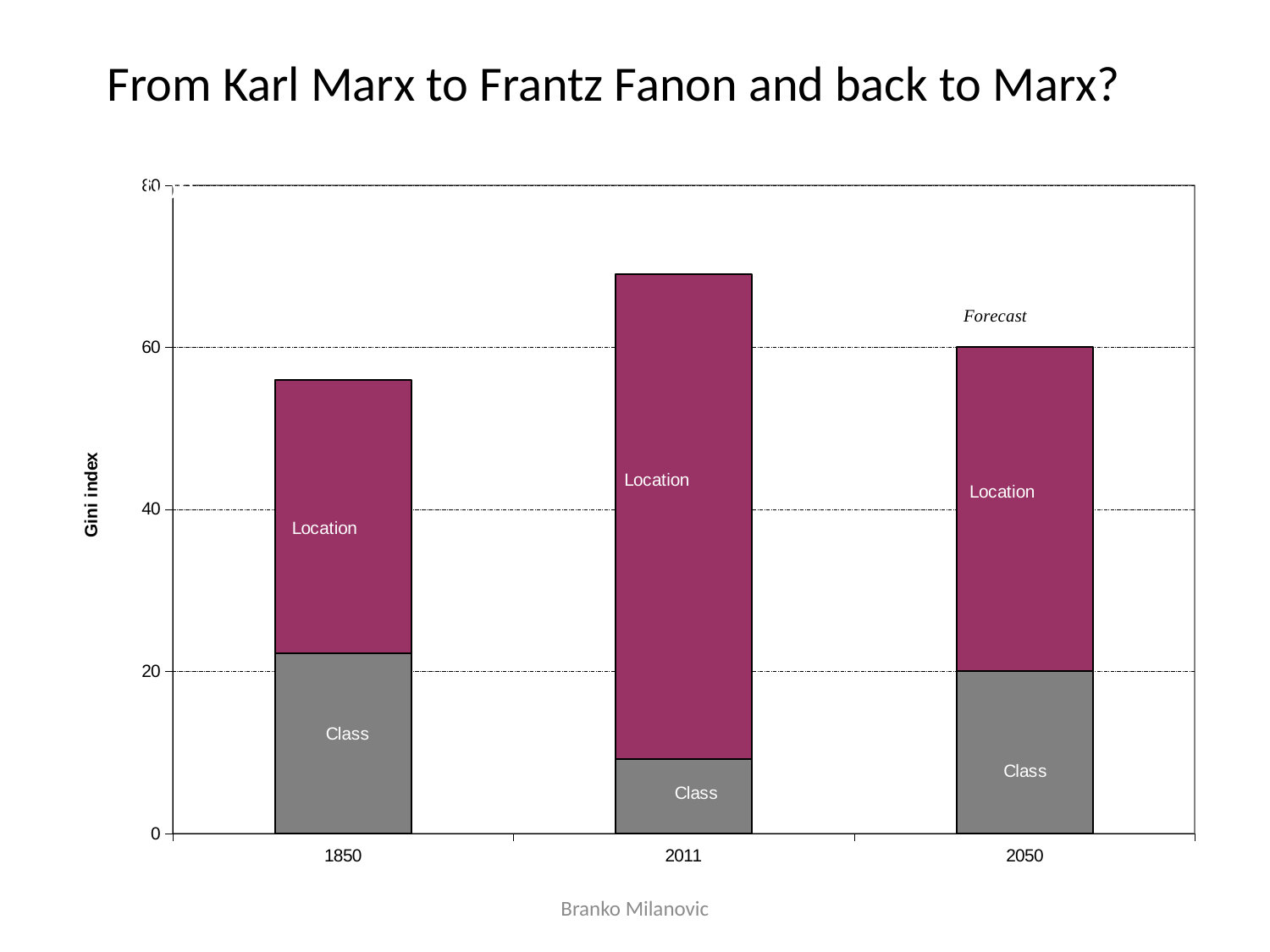
What kind of chart is shown on the slide? Stacked bar chart Is the total Gini index for 1850 greater or less than 60? less Is the total Gini index for 2011 greater or less than 60? greater Is the total bar for 2011 larger or smaller than the total bar for 2050? larger Which year has the smallest Class segment in the chart? 2011 Which year has the largest Location segment in the chart? 2011 How many years (categories) are shown on the x axis of the chart? 3 What label is shown on the vertical axis of the chart? Gini index How many series are stacked in each bar of the chart? 2 Which year has the shortest total bar in the chart? 1850 Which year has the tallest total bar in the chart? 2011 Is the Class segment for 2011 greater or less than 20? less